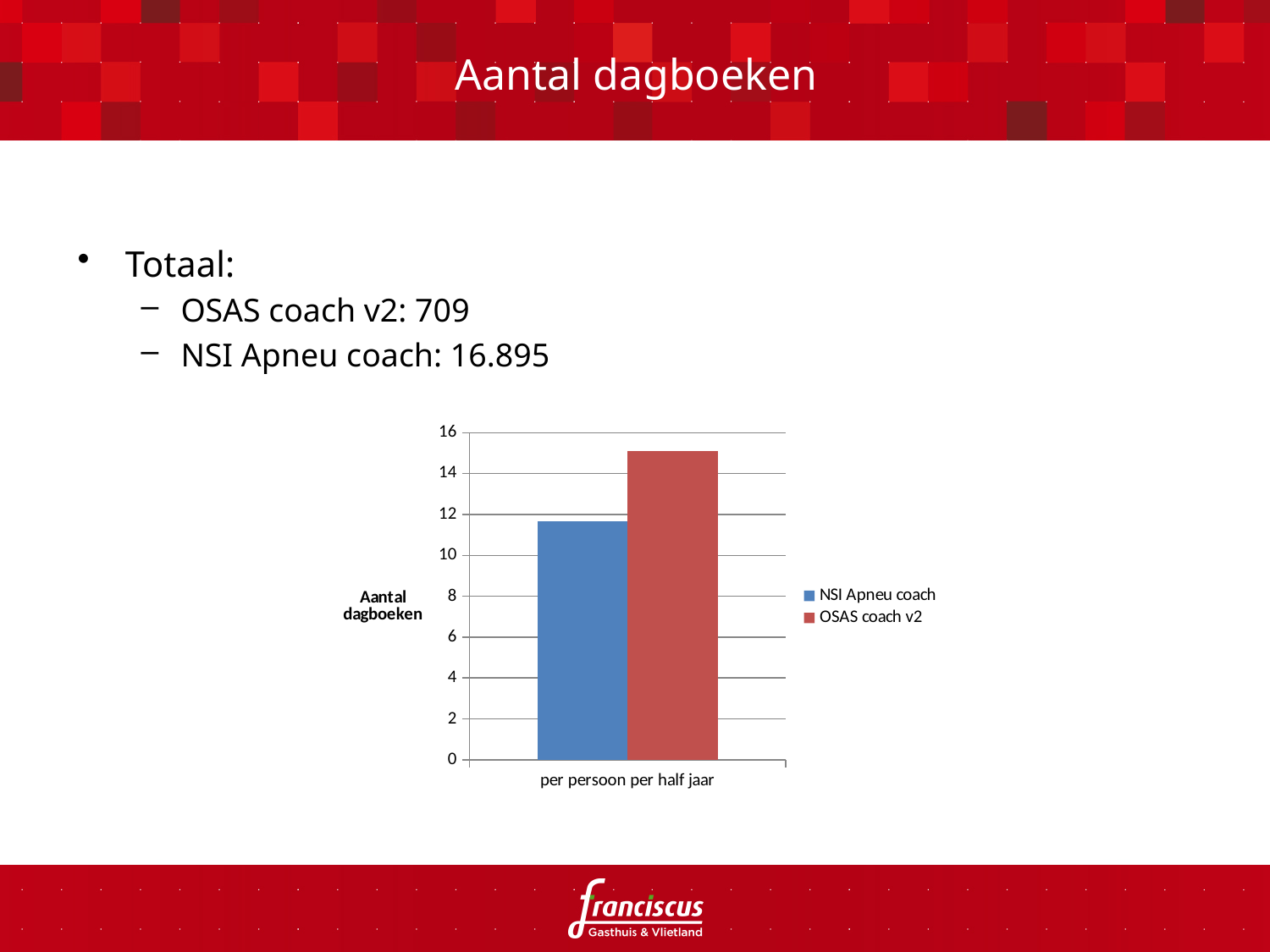
What is the title of the vertical axis of the chart? Aantal dagboeken How many categories are shown on the x axis of the chart? 1 What is the label of the category on the x axis of the chart? per persoon per half jaar Which series has the taller bar, NSI Apneu coach or OSAS coach v2? OSAS coach v2 How many series does the chart legend list? 2 Which series has the highest value in the chart? OSAS coach v2 Is the value for NSI Apneu coach greater or less than 10? greater Is the value for OSAS coach v2 greater or less than 16? less What kind of chart is shown on the slide? bar chart Which series has the lowest value in the chart? NSI Apneu coach Is the value for OSAS coach v2 greater or less than 14? greater